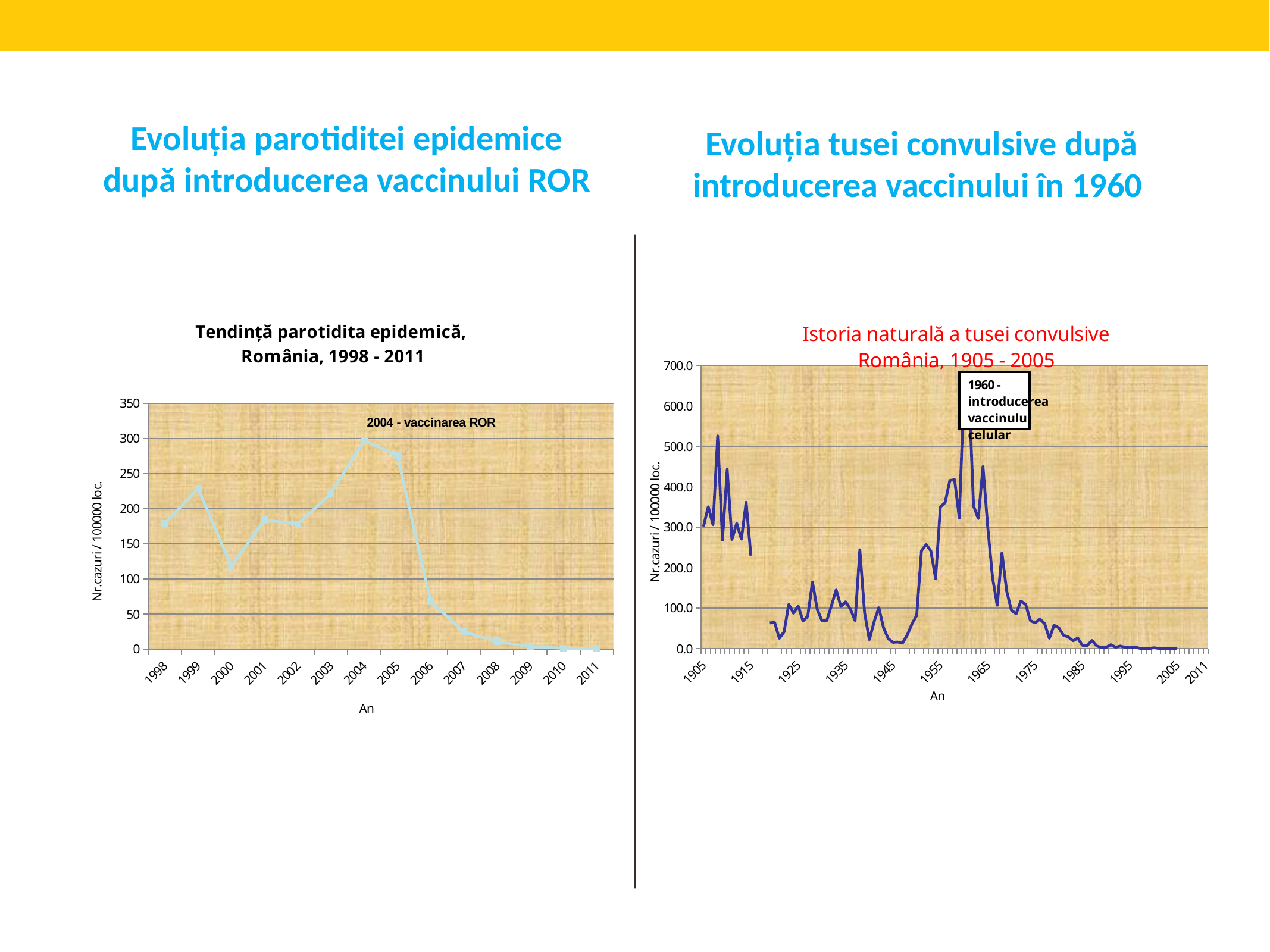
In the left chart, 'Tendință parotidita epidemică', how many years are shown on the x axis? 14 What event does the annotation on the left chart, 'Tendință parotidita epidemică', mark? 2004 - vaccinarea ROR In the left chart, 'Tendință parotidita epidemică', do the values rise or fall from 2005 to 2011? fall In the right chart, 'Istoria naturală a tusei convulsive', is the peak value around 1960 greater or less than 500.0? greater In the left chart, 'Tendință parotidita epidemică', which is larger, the value for 1999 or the value for 2000? 1999 In the left chart, 'Tendință parotidita epidemică', which year has the highest value? 2004 In the left chart, 'Tendință parotidita epidemică', is the value for 2006 greater or less than 100? less In the left chart, 'Tendință parotidita epidemică', is the value for 2000 greater or less than 150? less In the right chart, 'Istoria naturală a tusei convulsive', do the values rise or fall from 1965 to 2005? fall What kind of chart is the left chart, 'Tendință parotidita epidemică, România, 1998 - 2011'? line chart What kind of chart is the right chart, 'Istoria naturală a tusei convulsive România, 1905 - 2005'? line chart